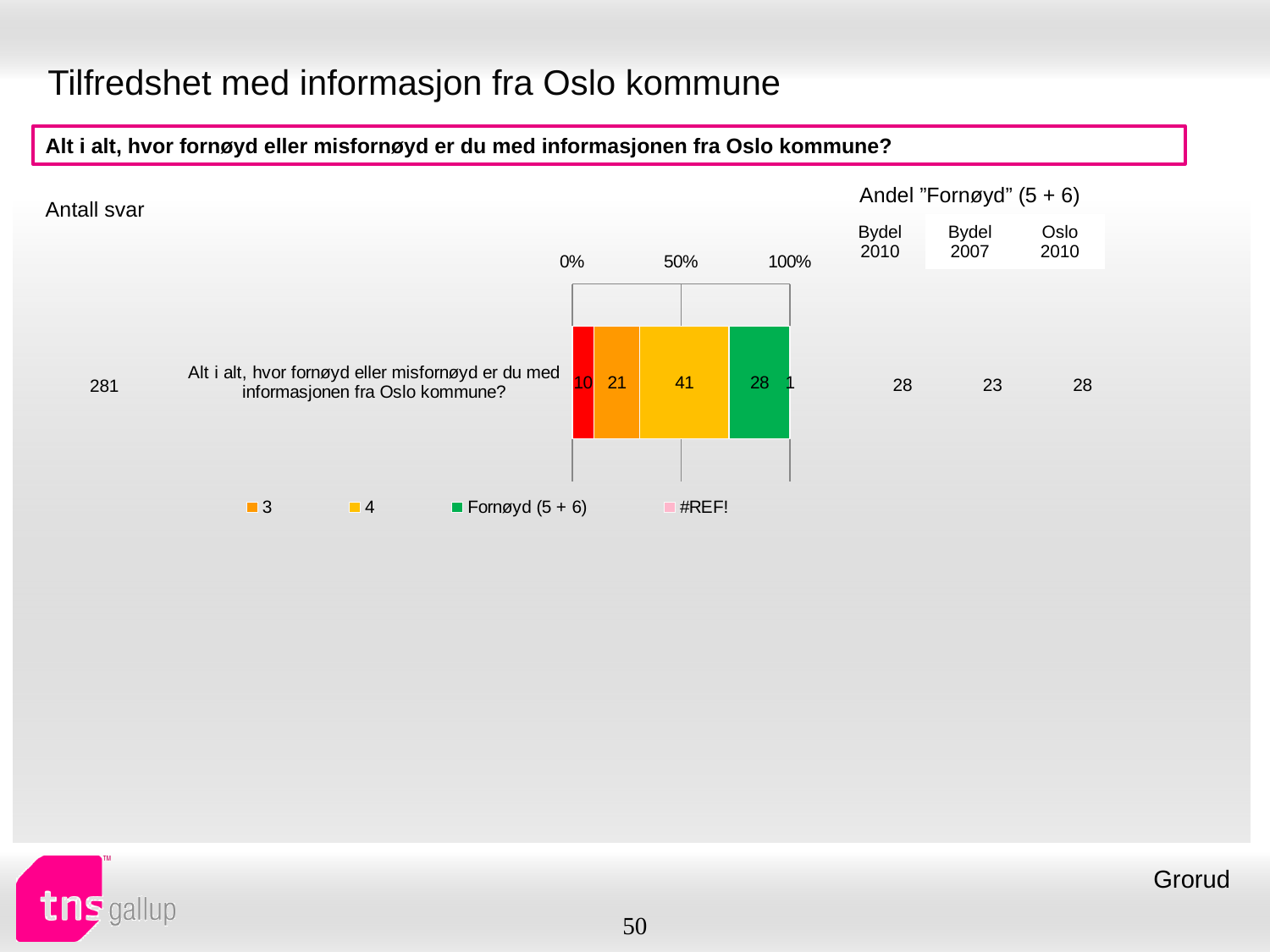
What is the difference between the "4" segment and the "Fornøyd (5 + 6)" segment? 13 How many bars does the chart contain? 1 What is the value of the "3" segment in the stacked bar? 21 What kind of chart is shown on the slide? Stacked bar chart How many series does the legend list? 4 What is the difference between the "4" segment and the "3" segment? 20 Which legend series has the largest segment in the stacked bar? 4 What is the value of the "4" segment in the stacked bar? 41 What is the value of the "#REF!" segment in the stacked bar? 1 What is the value of the "Fornøyd (5 + 6)" segment in the stacked bar? 28 Which is larger, the "3" segment or the "Fornøyd (5 + 6)" segment? Fornøyd (5 + 6) Which legend series has the smallest segment in the stacked bar? #REF!